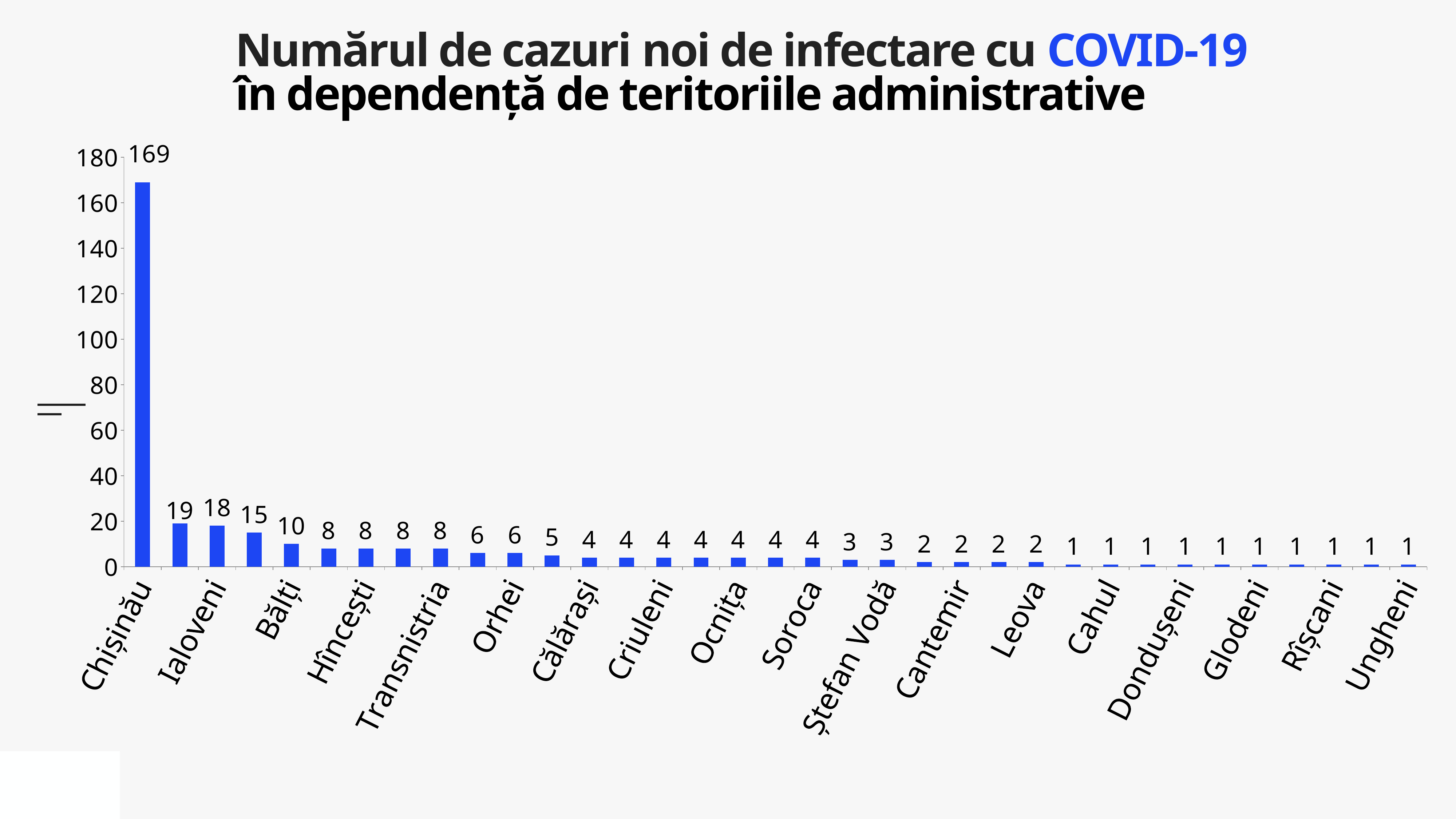
What colour are the bars in the chart? blue Do the values rise or fall from left to right along the x axis? fall Which territory has the highest number of new cases? Chișinău What is the value for Orhei? 6 What kind of chart is shown on the slide? bar chart What is the value for Ștefan Vodă? 3 What is the difference between the values for Chișinău and Transnistria? 161 What is the value for Chișinău? 169 What is the value for Hîncești? 8 What is the value for Ungheni? 1 Is the value for Chișinău greater or less than 160? greater Which is larger, the value for Orhei or the value for Soroca? Orhei